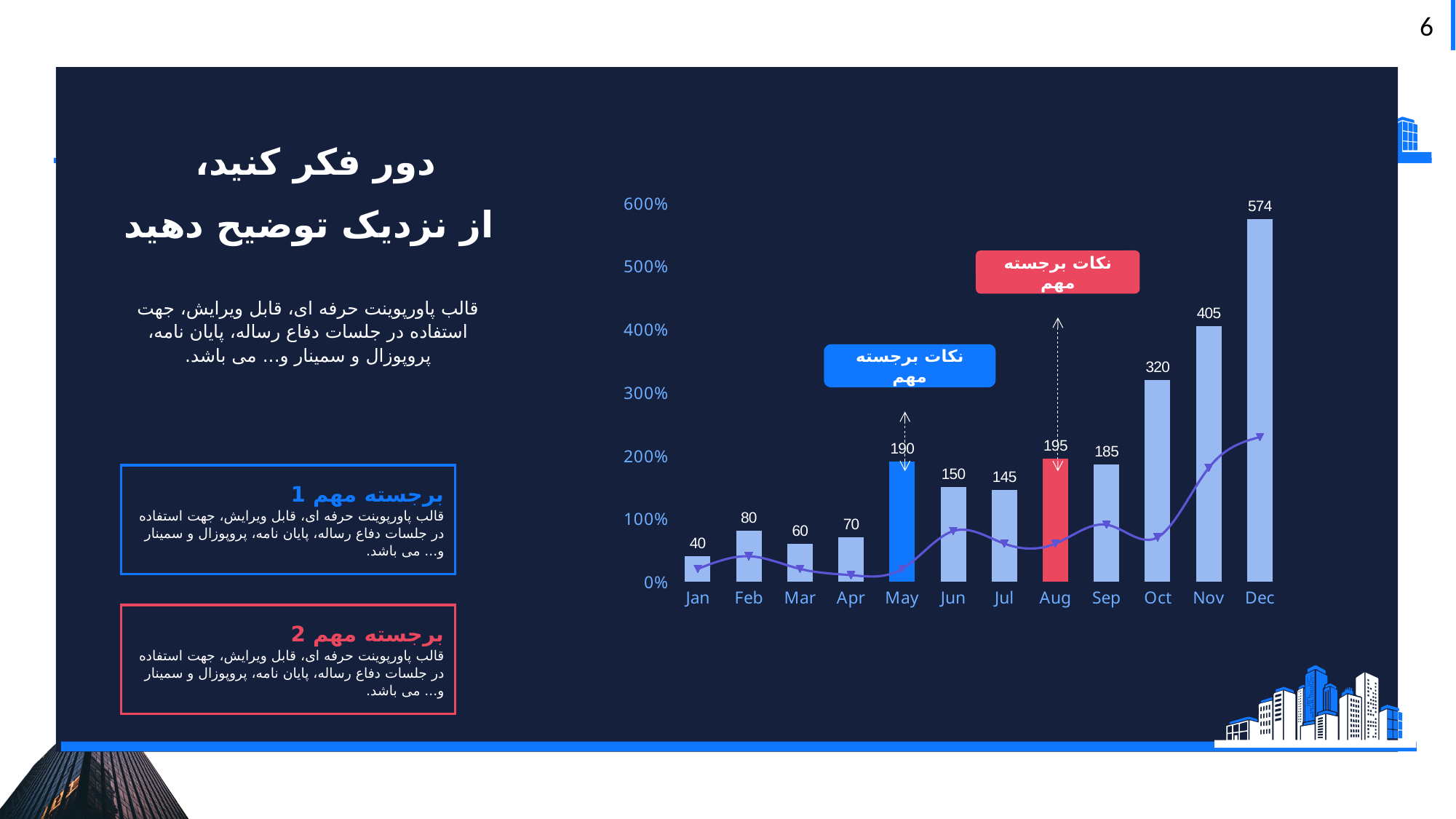
Which is larger, the value for Jun or the value for Jul? Jun Which is larger, the value for Mar or the value for Apr? Apr Which month has the lowest bar? Jan How many months are shown on the x axis? 12 What is the value for Dec? 574 What is the difference between the values for Nov and Oct? 85 What is the value for May? 190 Which month has the highest bar? Dec What kind of chart is shown on the slide? bar chart What is the difference between the values for Feb and Jan? 40 What is the value for Aug? 195 Do the bar values generally rise or fall from Sep to Dec? rise